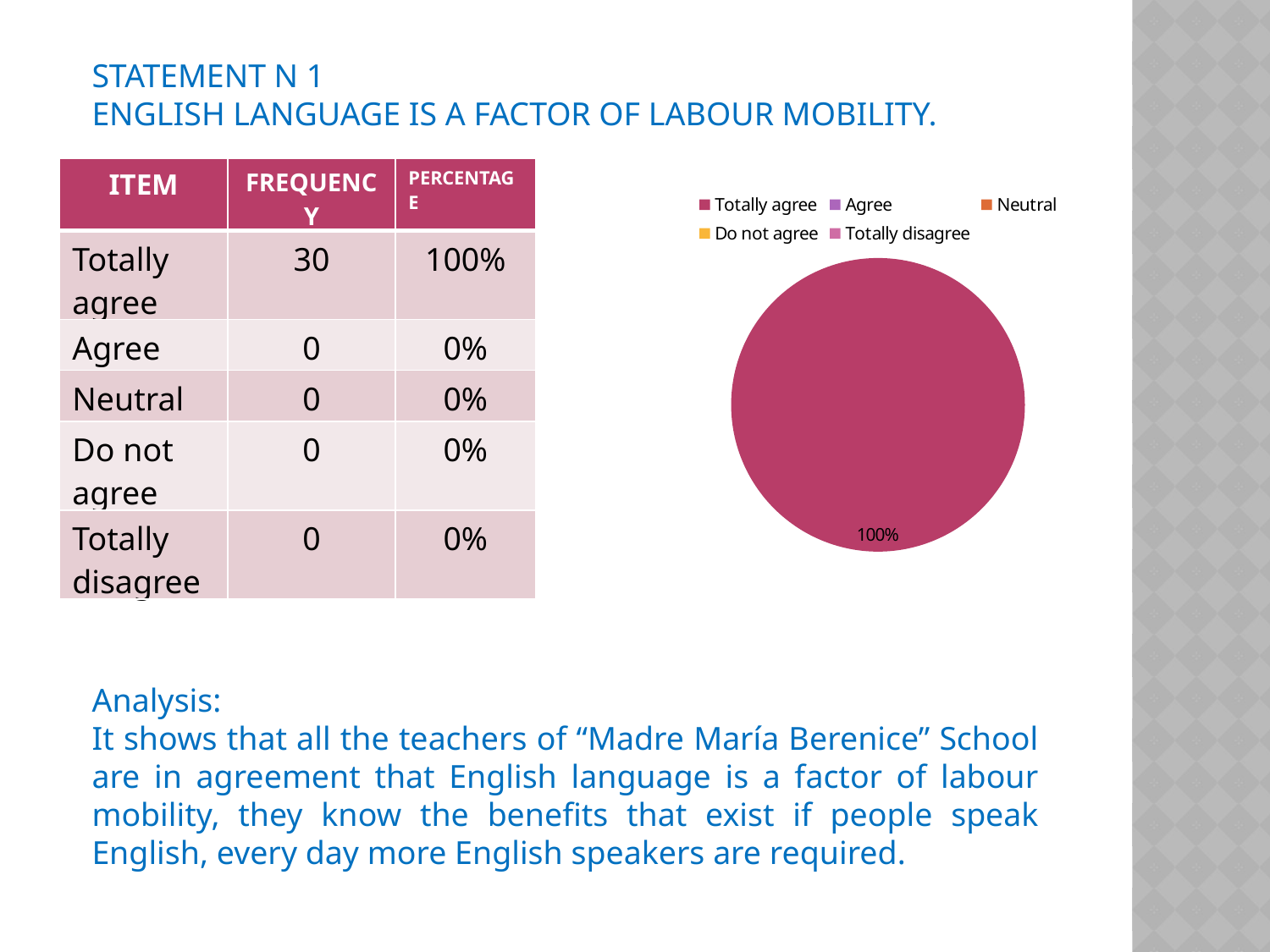
What share of the pie does the Totally agree slice represent? 100% What colour is the Totally agree slice in the pie chart? dark pink/magenta Is the share for Totally agree in the pie chart greater or less than 50%? greater Which legend entry is shown in orange in the pie chart? Neutral Which is larger in the pie chart, the share for Totally agree or the share for Agree? Totally agree What percentage is shown as the data label on the pie chart? 100% What kind of chart is shown on the slide? pie chart How many visible slices does the pie chart have? 1 Which category makes up the entire pie chart? Totally agree How many entries does the pie chart's legend list? 5